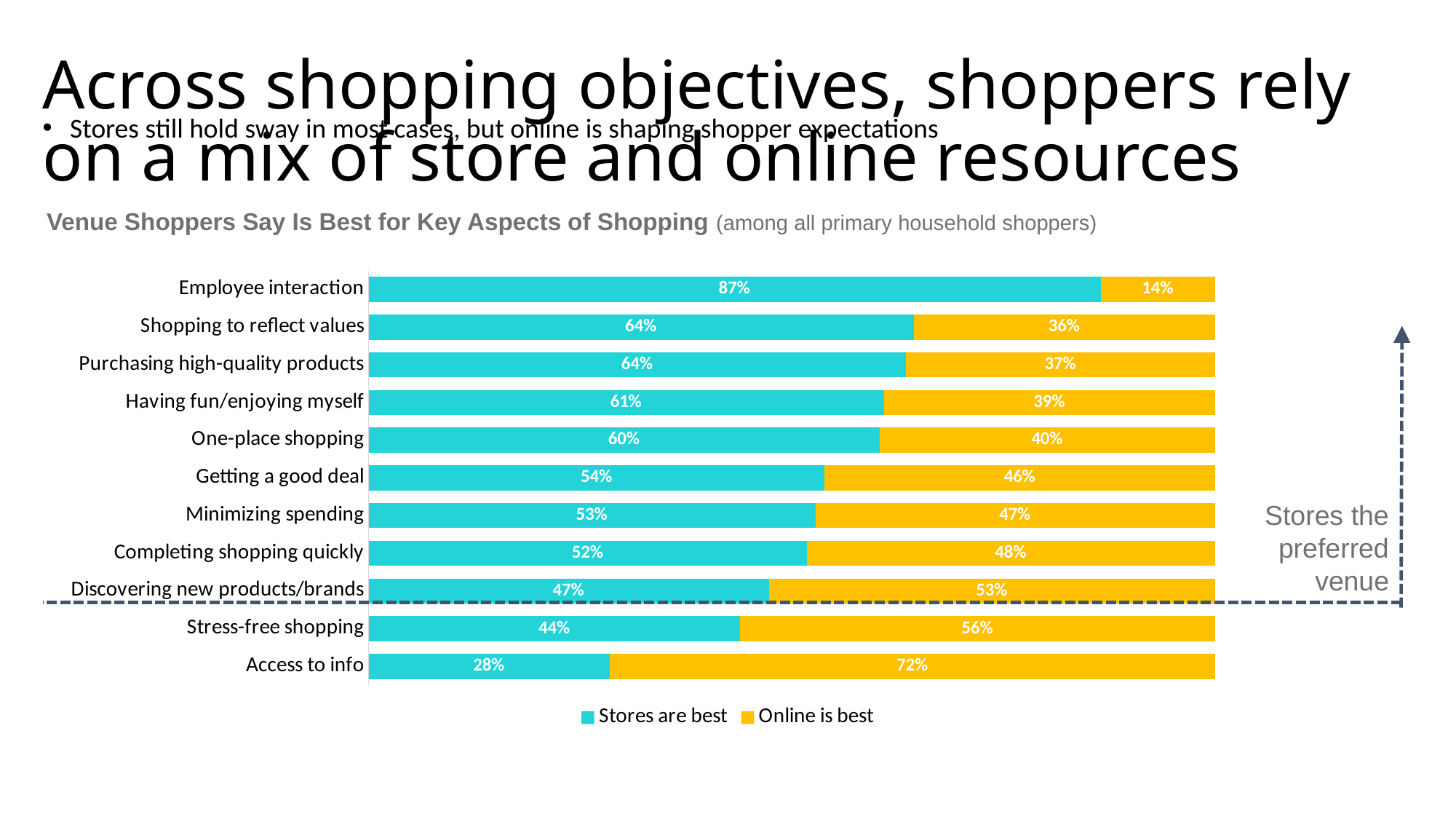
What is the total of the two segments for Purchasing high-quality products? 101% Which category has the lowest 'Stores are best' value? Access to info What is the difference between the 'Stores are best' and 'Online is best' values for Stress-free shopping? 12% Which category has the highest 'Stores are best' value? Employee interaction How many series does the legend list? 2 What percentage of shoppers say stores are best for Employee interaction? 87% How many categories are shown in the chart? 11 What kind of chart is shown on the slide? Stacked bar chart What percentage of shoppers say online is best for Access to info? 72% For Discovering new products/brands, which is larger: 'Stores are best' or 'Online is best'? Online is best Which colour represents 'Online is best' in the chart? Yellow What is the 'Online is best' value for Getting a good deal? 46%